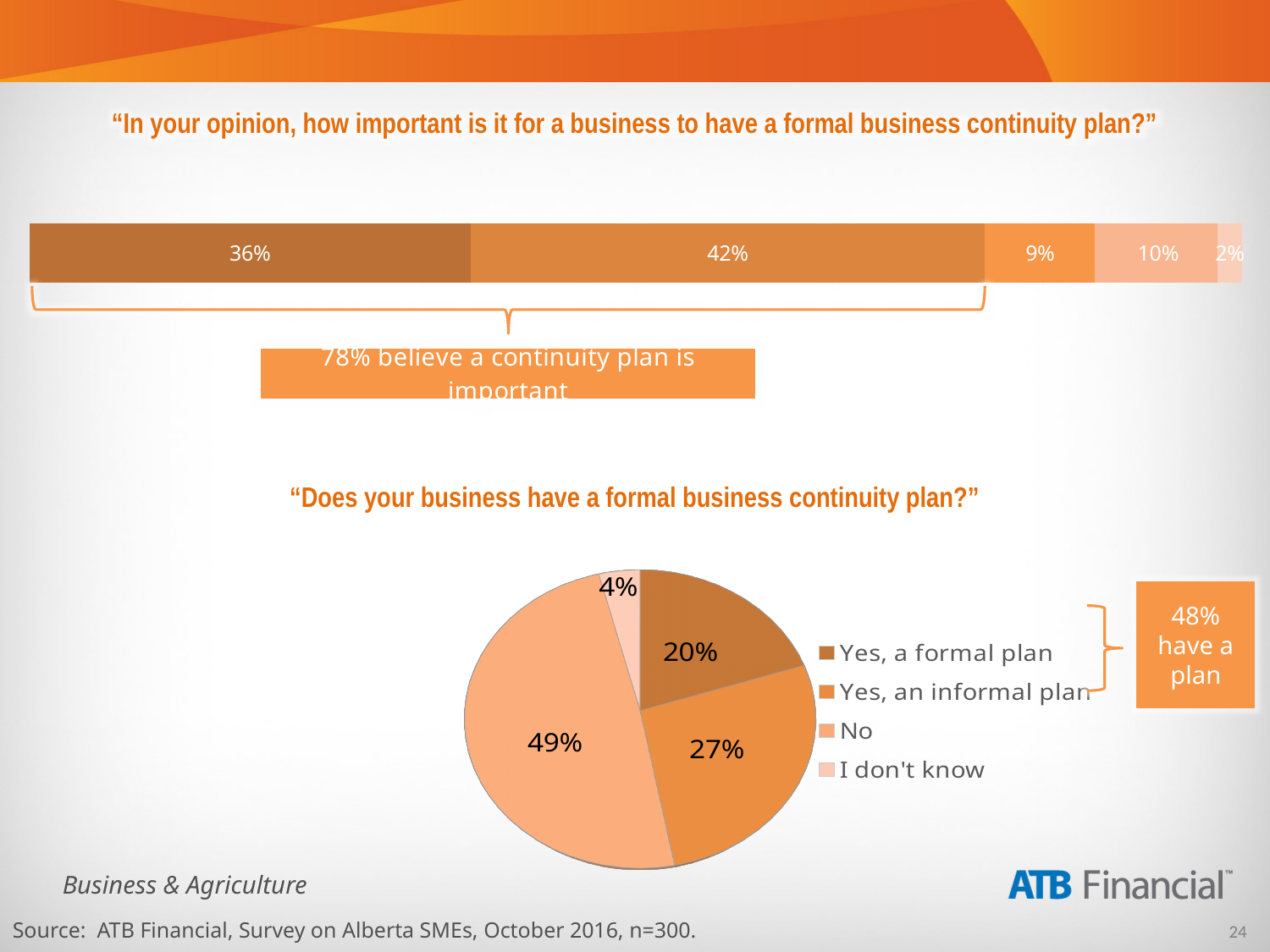
In the pie chart for "Does your business have a formal business continuity plan?", what percentage answered "Yes, an informal plan"? 27% In the pie chart for "Does your business have a formal business continuity plan?", which response has the smallest share? I don't know In the pie chart for "Does your business have a formal business continuity plan?", what percentage answered "Yes, a formal plan"? 20% In the pie chart for "Does your business have a formal business continuity plan?", which is larger: "Yes, an informal plan" or "Yes, a formal plan"? Yes, an informal plan In the pie chart for "Does your business have a formal business continuity plan?", what percentage answered "No"? 49% In the pie chart for "Does your business have a formal business continuity plan?", which response has the largest share? No What type of chart is used for "In your opinion, how important is it for a business to have a formal business continuity plan?"? Bar chart In the bar chart for "In your opinion, how important is it for a business to have a formal business continuity plan?", how many segments make up the bar? 5 How many response categories does the legend of the pie chart for "Does your business have a formal business continuity plan?" list? 4 What type of chart is used for "Does your business have a formal business continuity plan?"? Pie chart In the bar chart for "In your opinion, how important is it for a business to have a formal business continuity plan?", what is the value of the largest segment? 42% In the pie chart for "Does your business have a formal business continuity plan?", what is the difference between the "No" share and the "Yes, a formal plan" share? 29%